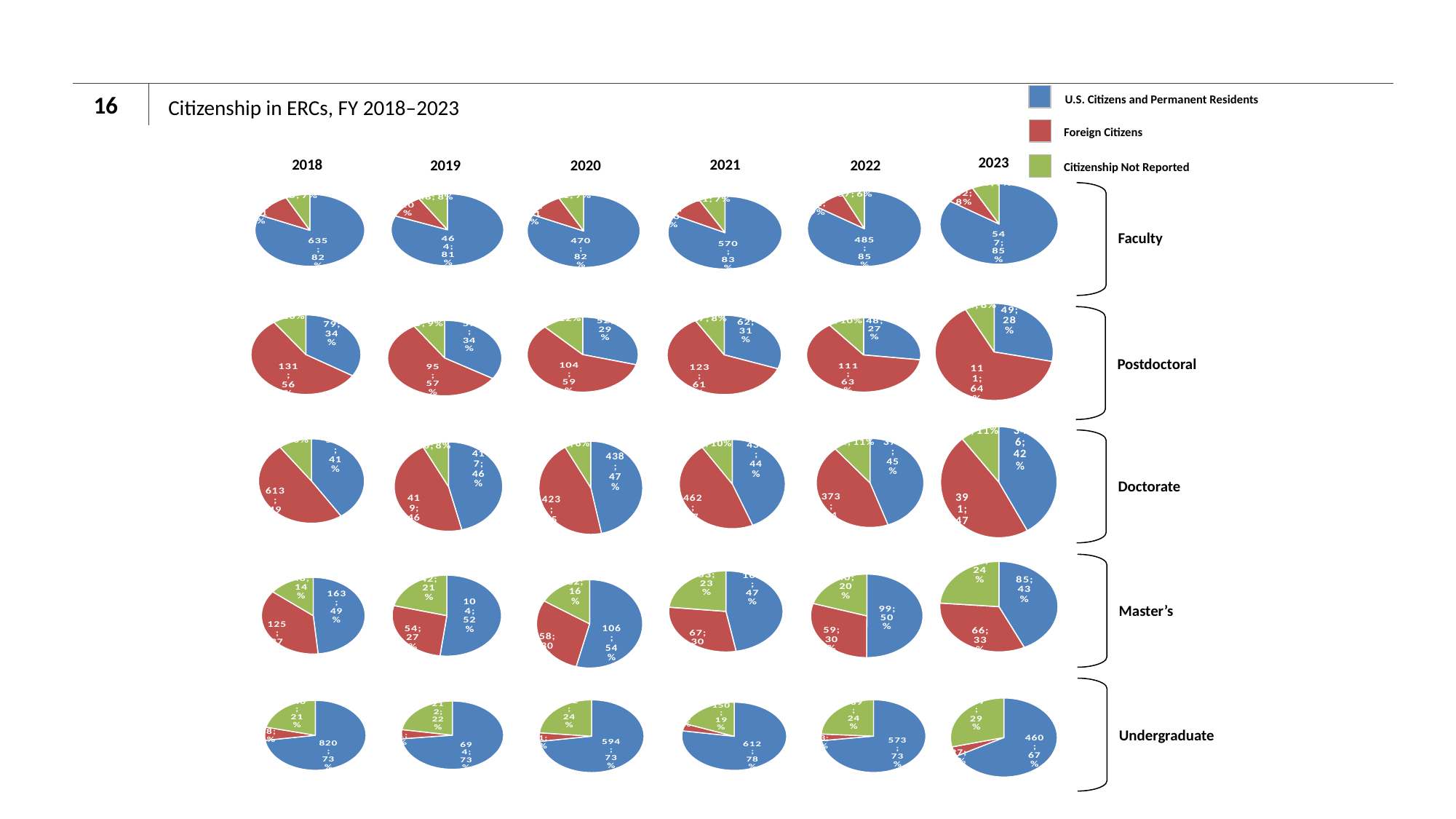
In the Master's 2023 pie chart, what is the value shown for U.S. Citizens and Permanent Residents? 85; 43% In the Postdoctoral 2018 pie chart, what is the value shown for Foreign Citizens? 131; 56% What kind of charts are shown on the slide? Pie charts In the Postdoctoral 2023 pie chart, what share of the pie is Foreign Citizens? 64% In the Master's 2019 pie chart, which slice is the largest? U.S. Citizens and Permanent Residents Which colour represents Citizenship Not Reported in the legend? Green How many series does the legend list? 3 In the Faculty 2018 pie chart, what is the value shown for U.S. Citizens and Permanent Residents? 635; 82% In the Undergraduate 2021 pie chart, what is the value shown for U.S. Citizens and Permanent Residents? 612; 78% In the Undergraduate 2023 pie chart, what share of the pie is Citizenship Not Reported? 29% In the Postdoctoral 2022 pie chart, which is larger: Foreign Citizens or U.S. Citizens and Permanent Residents? Foreign Citizens